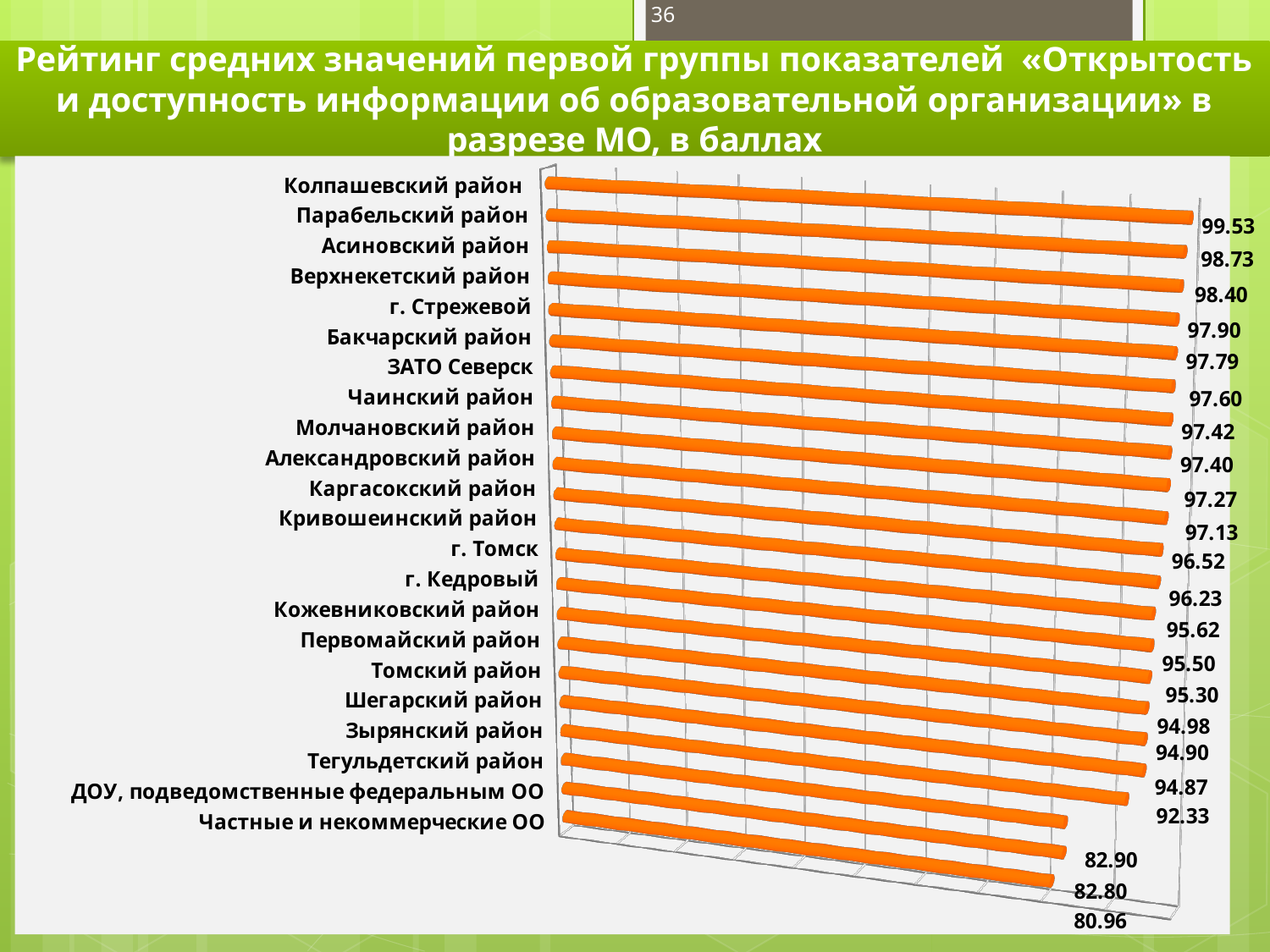
Do the values rise or fall going from the top category to the bottom category? fall What colour are the bars in the chart? orange What is the value for Колпашевский район? 99.53 How many categories (municipalities/groups) are plotted in the chart? 22 What is the value for г. Томск? 95.62 What is the value for ЗАТО Северск? 97.42 What is the difference between the values for Колпашевский район and Частные и некоммерческие ОО? 18.57 What kind of chart is shown on the slide? bar chart Which category has the lowest value? Частные и некоммерческие ОО Which has a larger value, Зырянский район or Тегульдетский район? Зырянский район What is the value for Частные и некоммерческие ОО? 80.96 Which category has the highest value? Колпашевский район